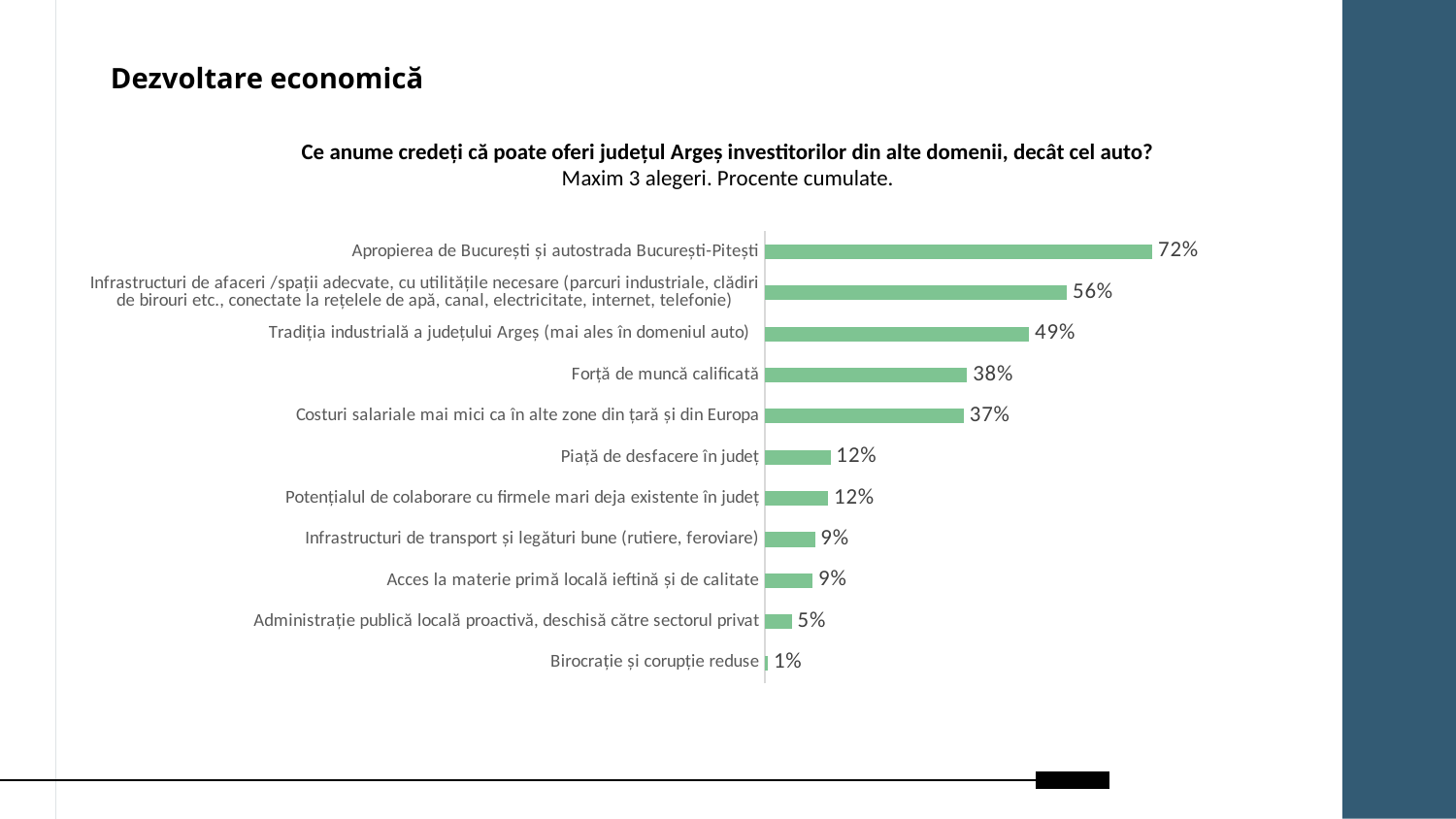
What kind of chart is shown on the slide? Bar chart What is the difference between the values for "Apropierea de București și autostrada București-Pitești" and "Tradiția industrială a județului Argeș (mai ales în domeniul auto)"? 23% Which category has the lowest value? Birocrație și corupție reduse What is the value for "Piață de desfacere în județ"? 12% How many categories are shown in the chart? 11 What is the value for "Apropierea de București și autostrada București-Pitești"? 72% What is the difference between the values for "Forță de muncă calificată" and "Costuri salariale mai mici ca în alte zone din țară și din Europa"? 1% What is the value for "Administrație publică locală proactivă, deschisă către sectorul privat"? 5% Which category has the highest value? Apropierea de București și autostrada București-Pitești Which is larger: the value for "Tradiția industrială a județului Argeș (mai ales în domeniul auto)" or for "Costuri salariale mai mici ca în alte zone din țară și din Europa"? Tradiția industrială a județului Argeș (mai ales în domeniul auto) What question is the chart based on, according to the chart title? Ce anume credeți că poate oferi județul Argeș investitorilor din alte domenii, decât cel auto? What is the value for "Forță de muncă calificată"? 38%